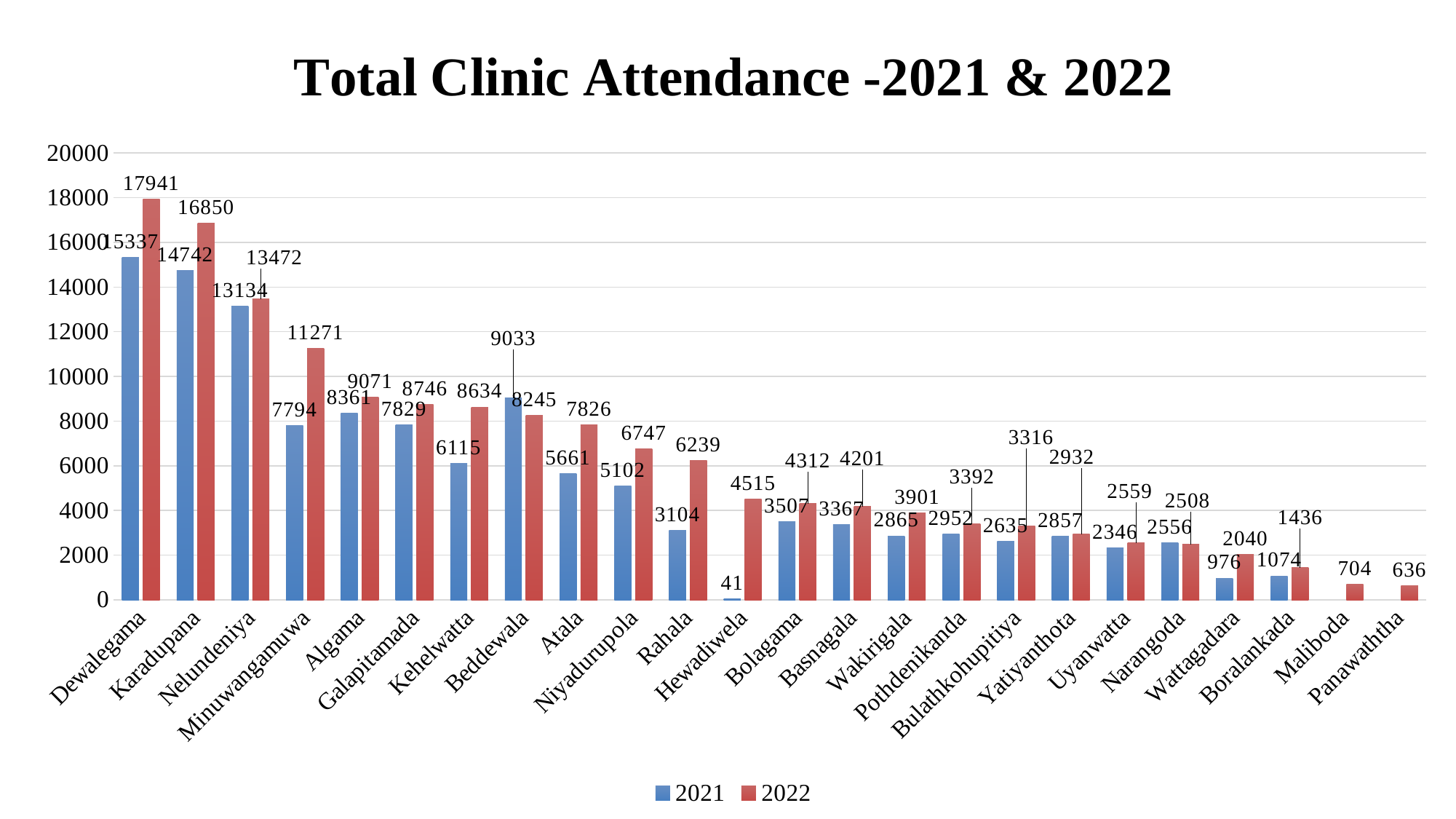
What was the clinic attendance for Hewadiwela in 2021? 41 For Beddewala, was attendance higher in 2021 or 2022? 2021 Which clinic had the highest attendance in 2022? Dewalegama What is the title of the chart? Total Clinic Attendance -2021 & 2022 What was the clinic attendance for Dewalegama in 2022? 17941 How many series does the legend list? 2 What is the difference between the 2022 and 2021 attendance for Minuwangamuwa? 3477 How many clinics are shown on the x axis? 24 What kind of chart is shown on the slide? Bar chart What was the clinic attendance for Rahala in 2022? 6239 Which clinic had the lowest attendance in 2022? Panawaththa Is the 2022 attendance for Kehelwatta greater or less than 8000? greater